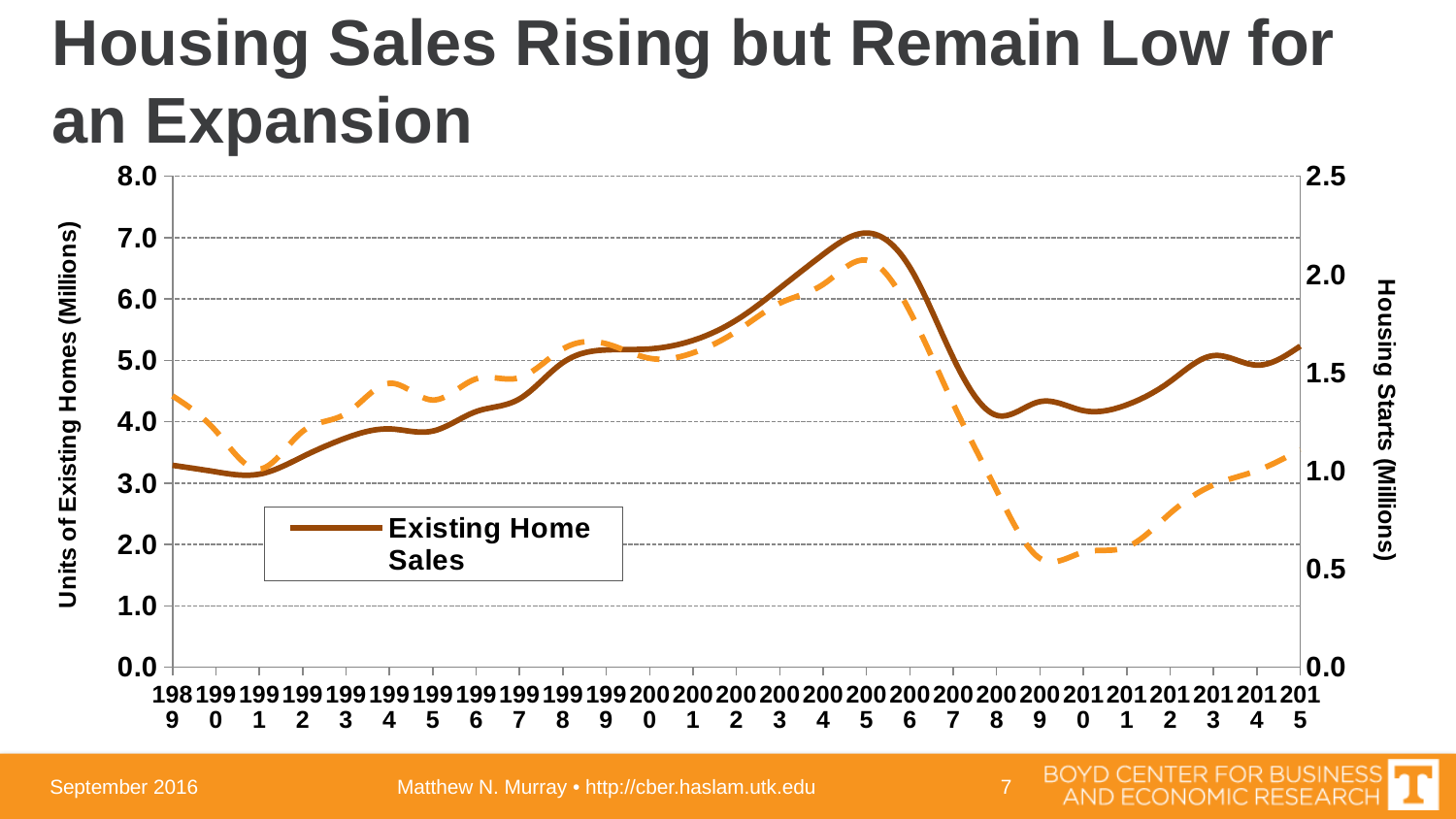
Is the Existing Home Sales value for 2005 greater or less than 6.0? greater In which year does the Existing Home Sales line reach its highest value? 2005 Which year has the larger Existing Home Sales value, 2005 or 2015? 2005 How many series does the legend list? 1 Does the Existing Home Sales line rise or fall between 2005 and 2008? Fall What is the title of the chart on the slide? Housing Sales Rising but Remain Low for an Expansion How many years are labelled along the x axis? 27 What is the label of the left vertical axis? Units of Existing Homes (Millions) In which year does the Existing Home Sales line reach its lowest value? 1991 Is the Housing Starts value for 2009 greater or less than 1.0? less What kind of chart is shown on the slide? Line chart Is the Existing Home Sales value for 2009 greater or less than 5.0? less